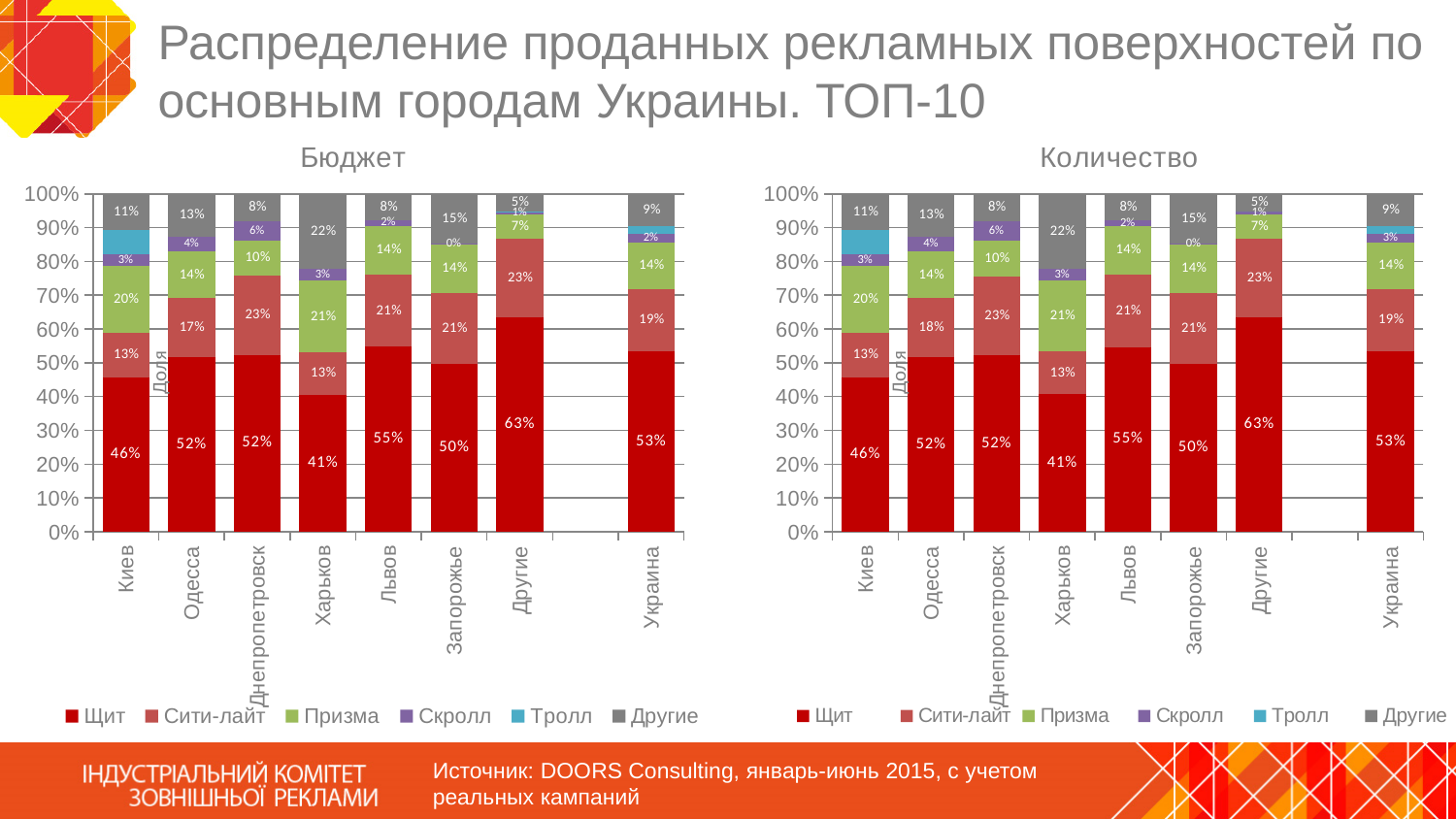
In the Бюджет chart, what is the difference between the Щит values for Львов and Киев? 9% In the Количество chart, what is the value of Сити-лайт for Одесса? 18% How many categories are shown on the x axis of the Бюджет chart? 8 What type of chart is the Бюджет chart? Stacked bar chart In the Количество chart, which is larger: the Другие series value for Харьков or for Запорожье? Харьков In the Бюджет chart, what is the value of Призма for Киев? 20% How many series does the legend of the Количество chart list? 6 In the Бюджет chart, what is the value of Щит for Харьков? 41% In the Количество chart, which category has the lowest Щит share? Харьков What is the title of the chart on the right side of the slide? Количество In the Бюджет chart, what is the value of Сити-лайт for Украина? 19% In the Бюджет chart, which category has the highest Щит share? Другие